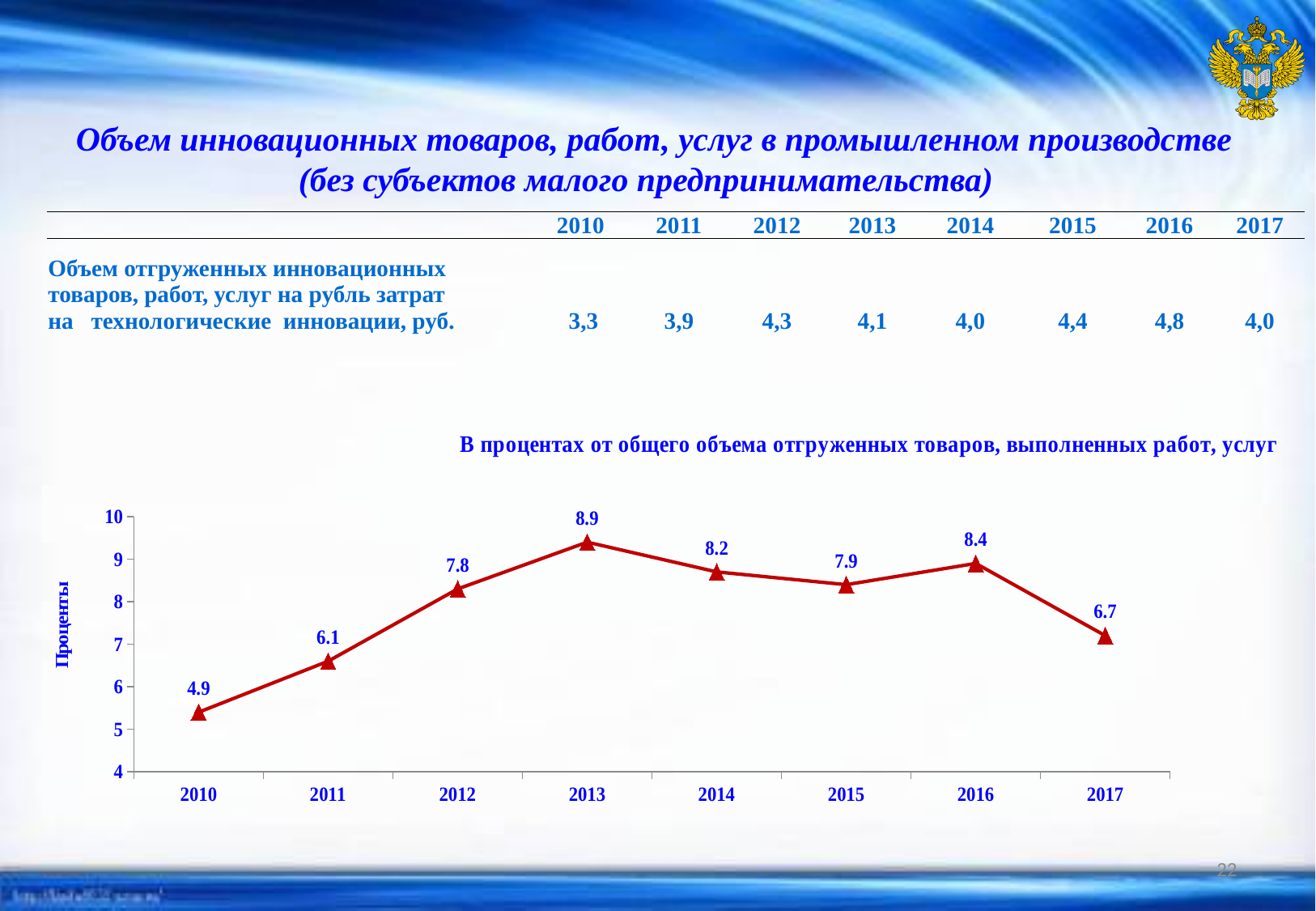
How many years are plotted in the line chart? 8 What is the value for 2013 in the line chart? 8.9 What is the value for 2010 in the line chart? 4.9 Which year has the highest value in the line chart? 2013 Does the value in the line chart rise or fall from 2016 to 2017? fall What is the value for 2017 in the line chart? 6.7 Which year has the lowest value in the line chart? 2010 What is the difference between the values for 2013 and 2010 in the line chart? 4.0 Which is larger in the line chart, the value for 2014 or the value for 2016? 2016 What type of chart is shown on the slide? line chart What is the label of the vertical axis of the line chart? Проценты What is the value for 2015 in the line chart? 7.9